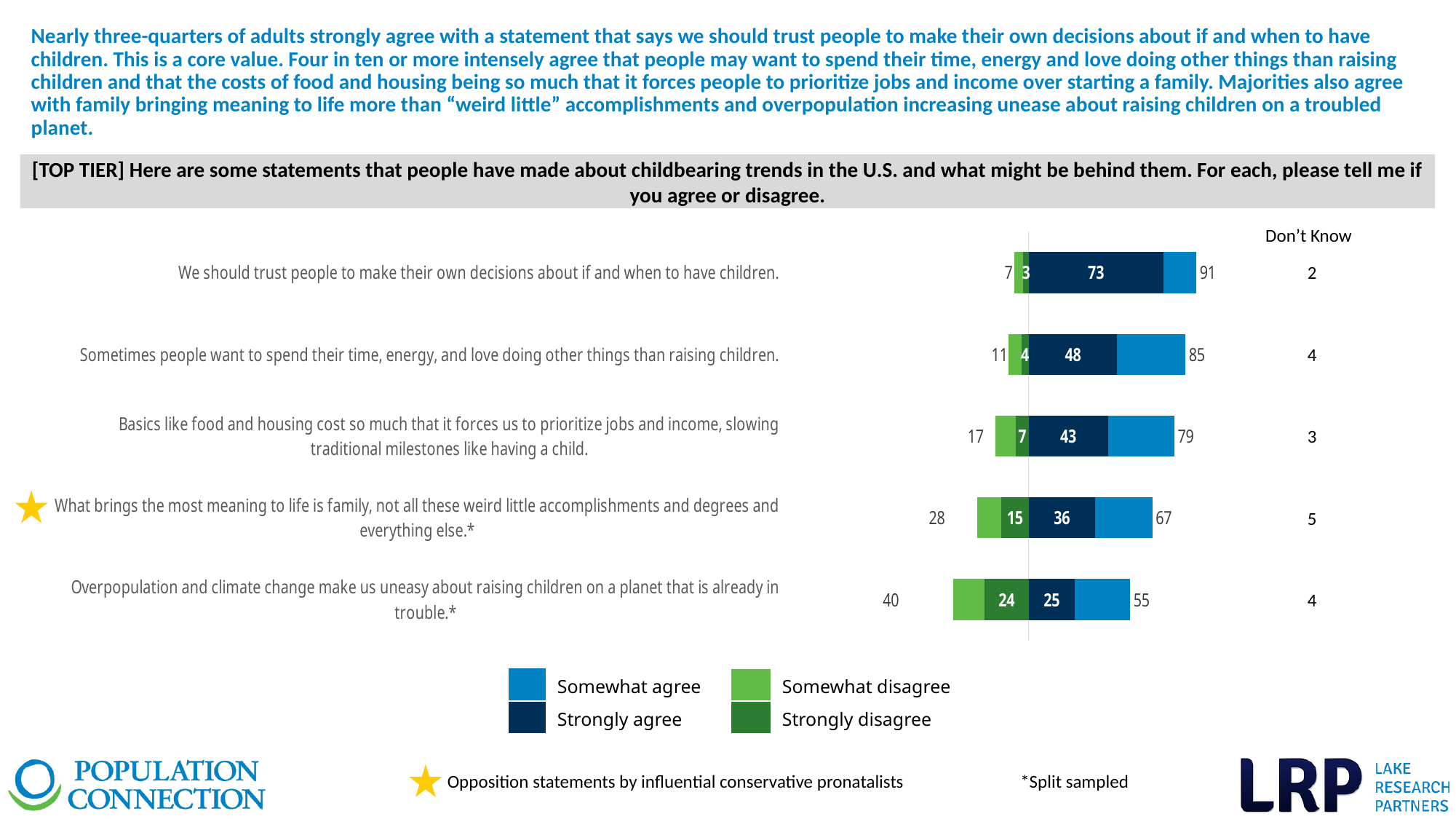
What kind of chart is shown on the slide? Stacked bar chart Which statement has the lowest strongly agree value? Overpopulation and climate change make us uneasy about raising children on a planet that is already in trouble. How many series does the legend list? 4 What is the Don't Know value for the statement that sometimes people want to spend their time, energy, and love doing other things than raising children? 4 Which statement has the highest total agree value? We should trust people to make their own decisions about if and when to have children. How many statements are plotted in the chart? 5 Which legend entry is shown in dark green? Strongly disagree What is the total agree value for the statement that overpopulation and climate change make us uneasy about raising children on a planet that is already in trouble? 55 What is the difference between the total agree values for the trust-people-to-make-their-own-decisions statement and the basics-like-food-and-housing statement? 12 Which is larger: the strongly disagree value for the overpopulation and climate change statement or the strongly agree value for that same statement? Strongly agree (25) What is the total disagree value for the statement that what brings the most meaning to life is family, not all these weird little accomplishments and degrees? 28 What percentage strongly agree that we should trust people to make their own decisions about if and when to have children? 73